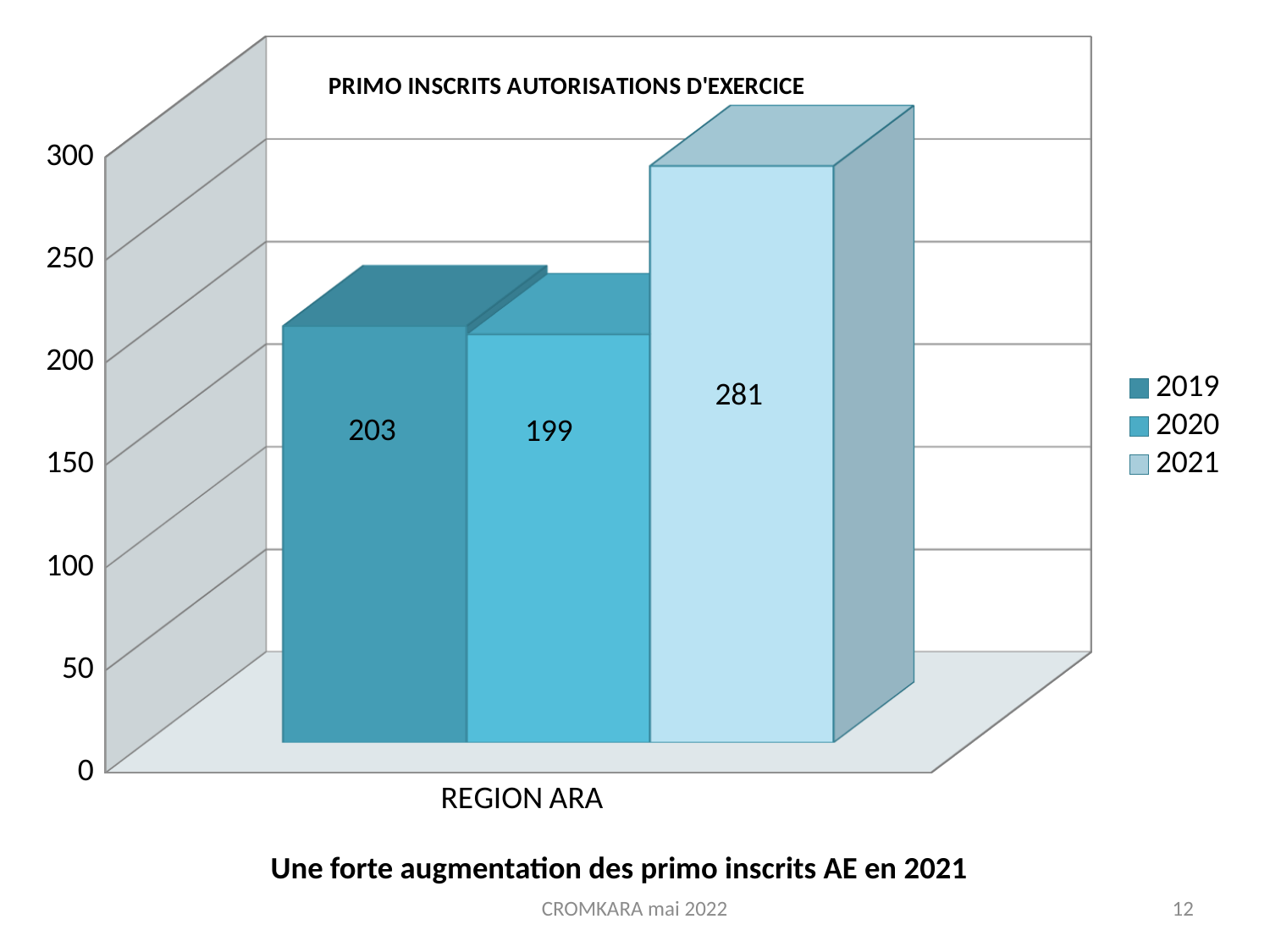
What is the value for 2020 in the chart? 199 What is the value for 2019 in the PRIMO INSCRITS AUTORISATIONS D'EXERCICE chart? 203 What is the value for 2021 in the chart? 281 Which is larger, the value for 2019 or the value for 2021? 2021 Is the value for 2021 greater or less than 250? greater What is the difference between the 2021 value and the 2020 value? 82 Which year has the lowest value in the chart? 2020 What kind of chart is shown on the slide? bar chart How many series does the legend list? 3 What is the difference between the 2019 value and the 2020 value? 4 What is the category label shown on the x axis of the chart? REGION ARA Which year has the highest value in the chart? 2021